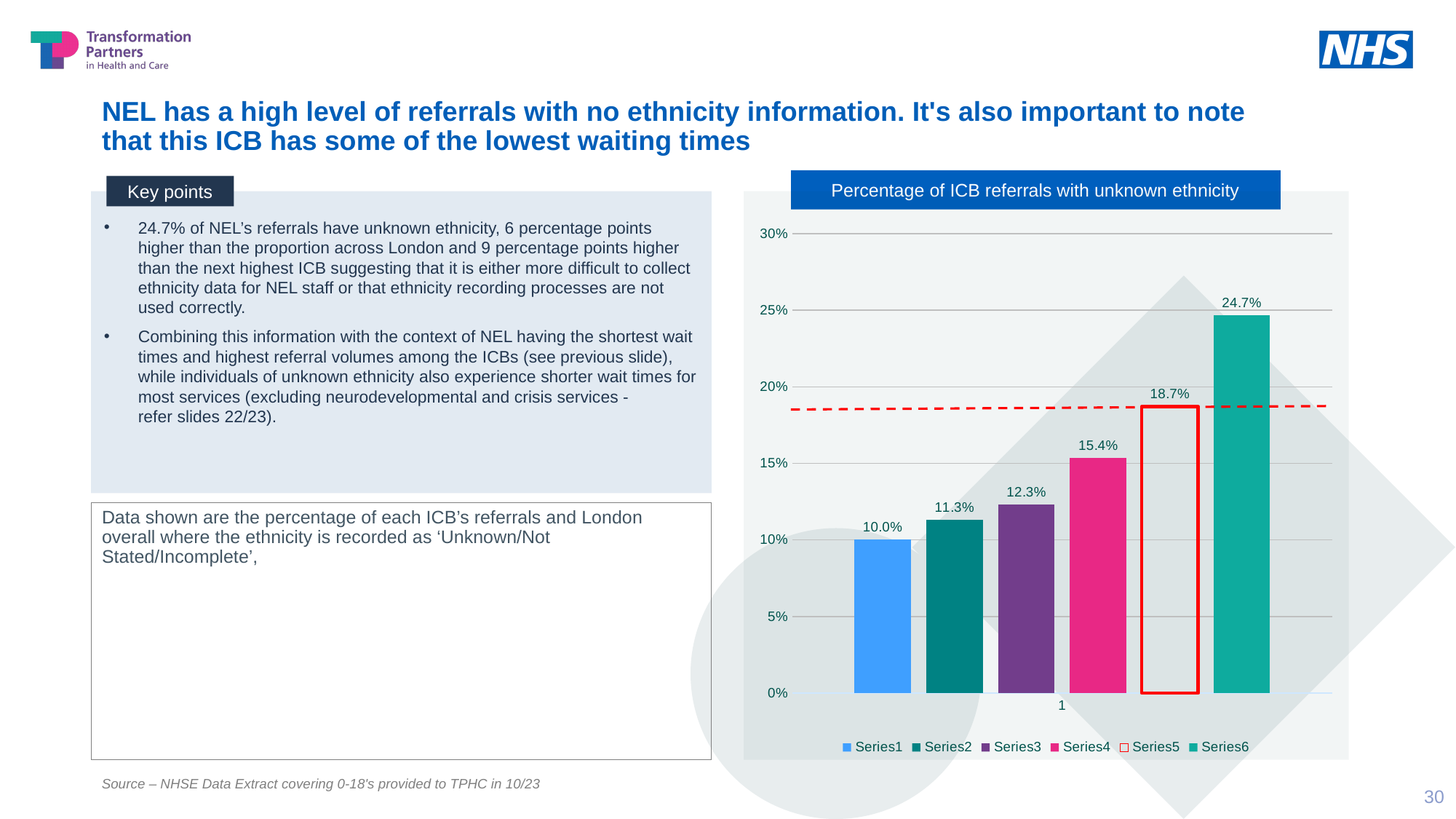
Is the value for Series6 greater or less than 20%? greater What is the difference between the values for Series6 and Series5? 6.0% What is the value for Series1? 10.0% How many series does the chart legend list? 6 Which is larger, the value for Series3 or the value for Series2? Series3 Which series has the lowest value? Series1 What type of chart is shown on the slide? bar chart What is the value for Series4? 15.4% Which series is drawn as a red outlined bar rather than a filled bar? Series5 Which series has the highest value? Series6 What is the value for Series5? 18.7% What is the title of the chart? Percentage of ICB referrals with unknown ethnicity